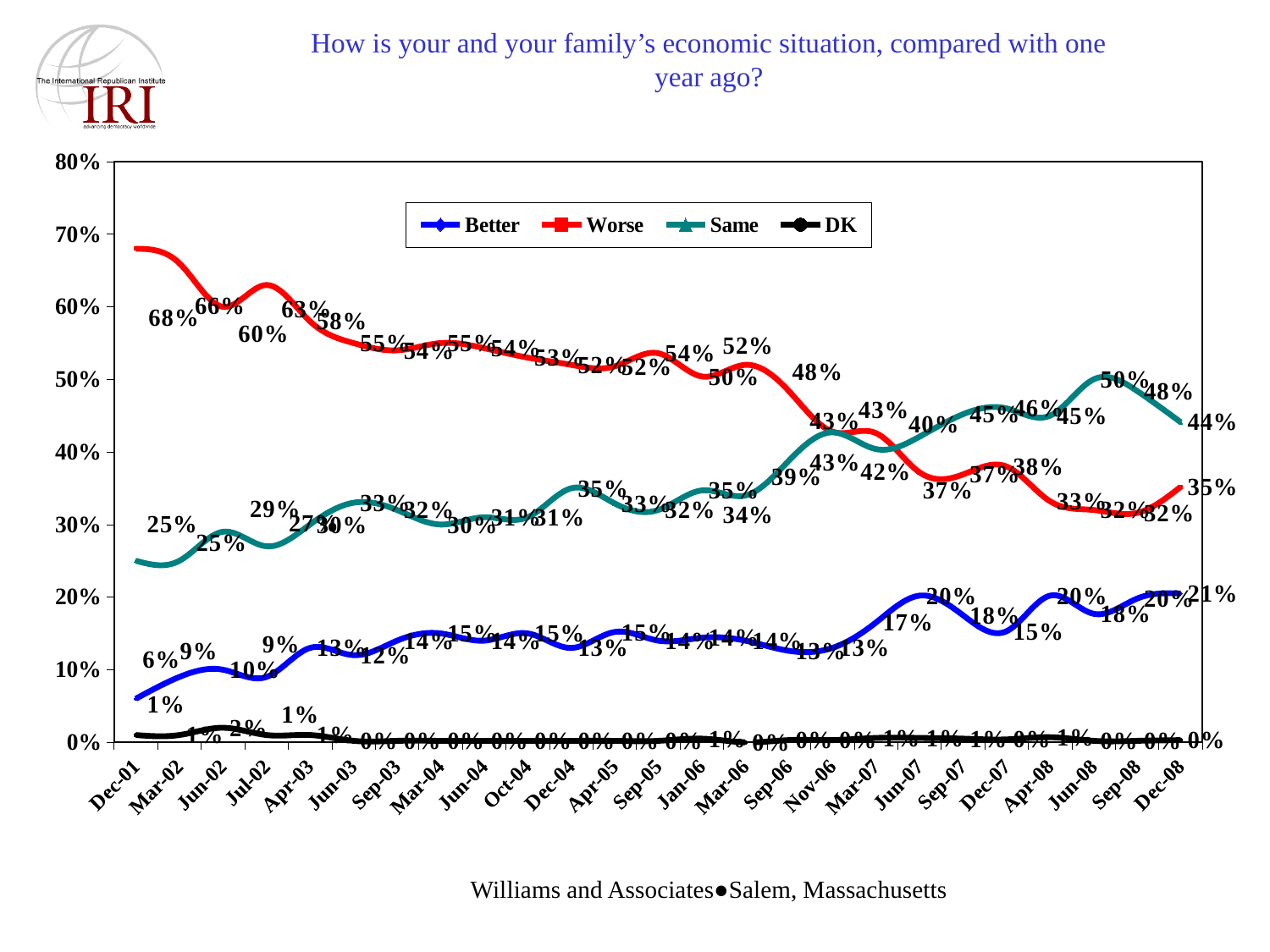
Does the "Worse" series generally rise or fall from Dec-01 to Dec-08? Fall What percentage said their economic situation was "Worse" in Dec-01? 68% What kind of chart is shown on the slide? Line chart At which date is the "Better" series at its lowest value? Dec-01 How many dates are shown along the x axis? 25 By how many percentage points did the "Worse" value fall from Dec-01 to Dec-08? 33 percentage points What is the value of the "Worse" series at Dec-08? 35% What is the value of the "Same" series at Dec-08? 44% What is the value of the "Better" series at Dec-08? 21% How many series does the legend list? 4 At which date does the "Same" series reach its highest value? Jun-08 At Dec-08, which is larger: the "Same" value or the "Worse" value? Same